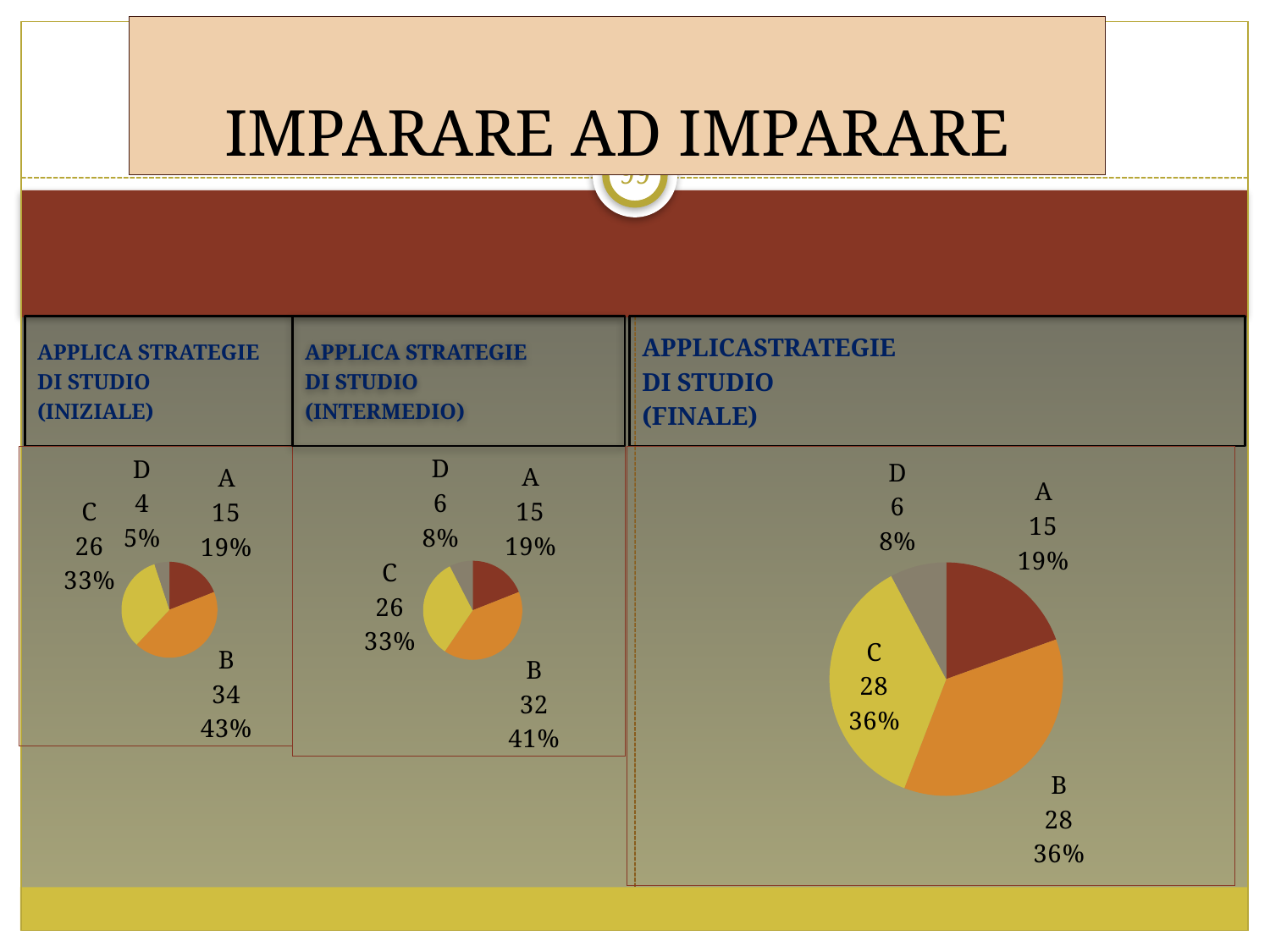
What type of chart is used for APPLICA STRATEGIE DI STUDIO (INIZIALE)? Pie chart In the APPLICA STRATEGIE DI STUDIO (INIZIALE) chart, what percentage share does category C have? 33% In the APPLICA STRATEGIE DI STUDIO (INIZIALE) chart, which category has the smallest value? D In the APPLICASTRATEGIE DI STUDIO (FINALE) chart, what percentage share does category A have? 19% In the APPLICA STRATEGIE DI STUDIO (INTERMEDIO) chart, which category has the largest value? B In the APPLICASTRATEGIE DI STUDIO (FINALE) chart, what is the value for category C? 28 In the APPLICA STRATEGIE DI STUDIO (INIZIALE) chart, what is the value for category B? 34 In the APPLICA STRATEGIE DI STUDIO (INIZIALE) chart, what is the difference between the values for B and A? 19 In the APPLICA STRATEGIE DI STUDIO (INTERMEDIO) chart, what percentage share does category B have? 41% In the APPLICASTRATEGIE DI STUDIO (FINALE) chart, which is larger, the value for A or the value for D? A In the APPLICA STRATEGIE DI STUDIO (INTERMEDIO) chart, what is the value for category D? 6 How many categories does the APPLICASTRATEGIE DI STUDIO (FINALE) chart show? 4